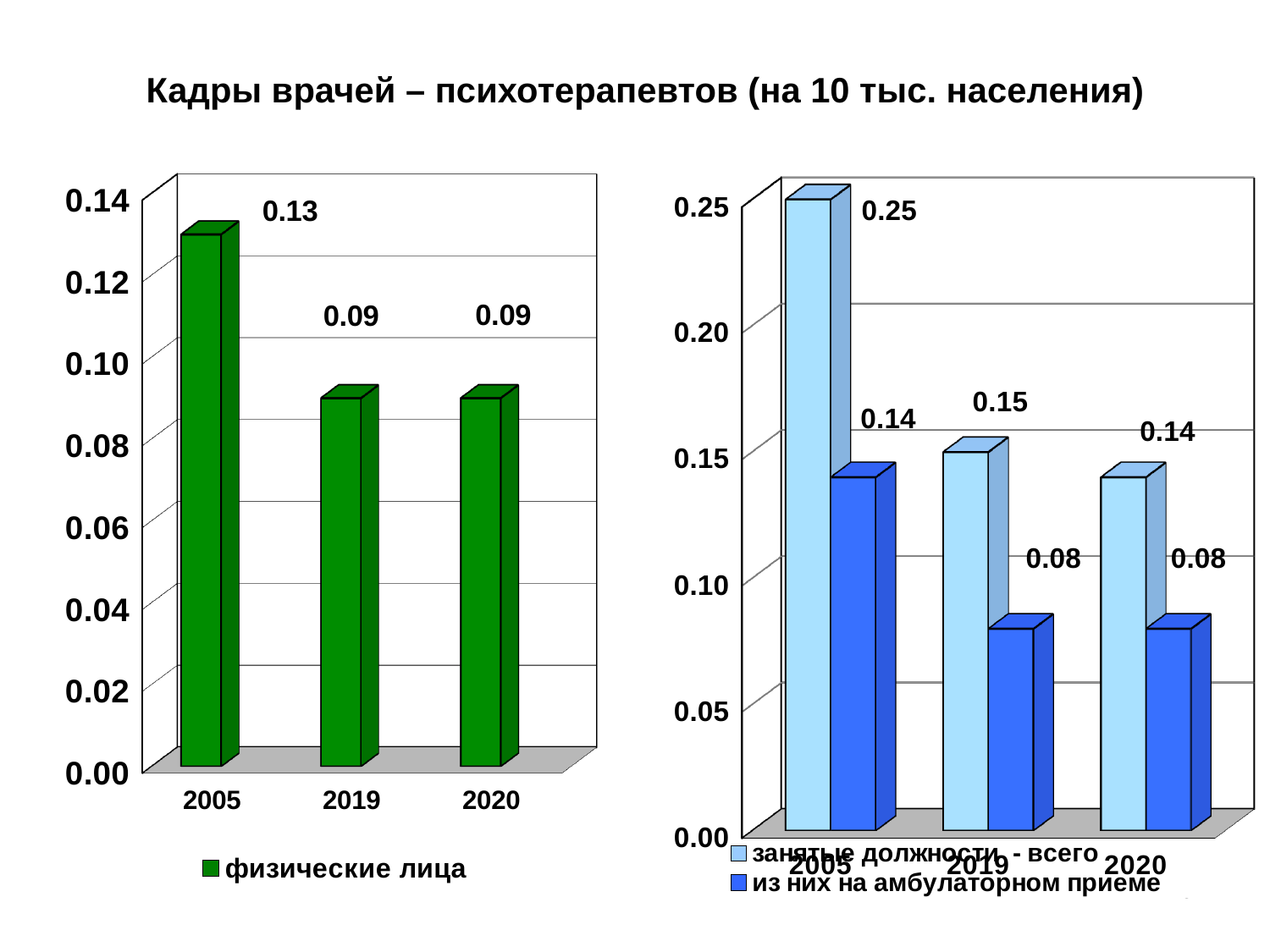
In the right chart, which is larger in 2019: занятые должности - всего or из них на амбулаторном приеме? занятые должности - всего In the right chart, what is the value for занятые должности - всего in 2020? 0.14 In the left chart, what is the value for физические лица in 2005? 0.13 What kind of chart is the left chart? bar chart In the left chart, what is the value for физические лица in 2020? 0.09 In the left chart, which year has the highest value? 2005 In the left chart, how many years are shown on the x axis? 3 In the right chart, what is the value for из них на амбулаторном приеме in 2019? 0.08 In the right chart, how many series does the legend list? 2 In the right chart, what is the value for занятые должности - всего in 2005? 0.25 In the right chart, what is the difference between занятые должности - всего and из них на амбулаторном приеме in 2005? 0.11 In the left chart, what is the difference between the 2005 value and the 2019 value? 0.04